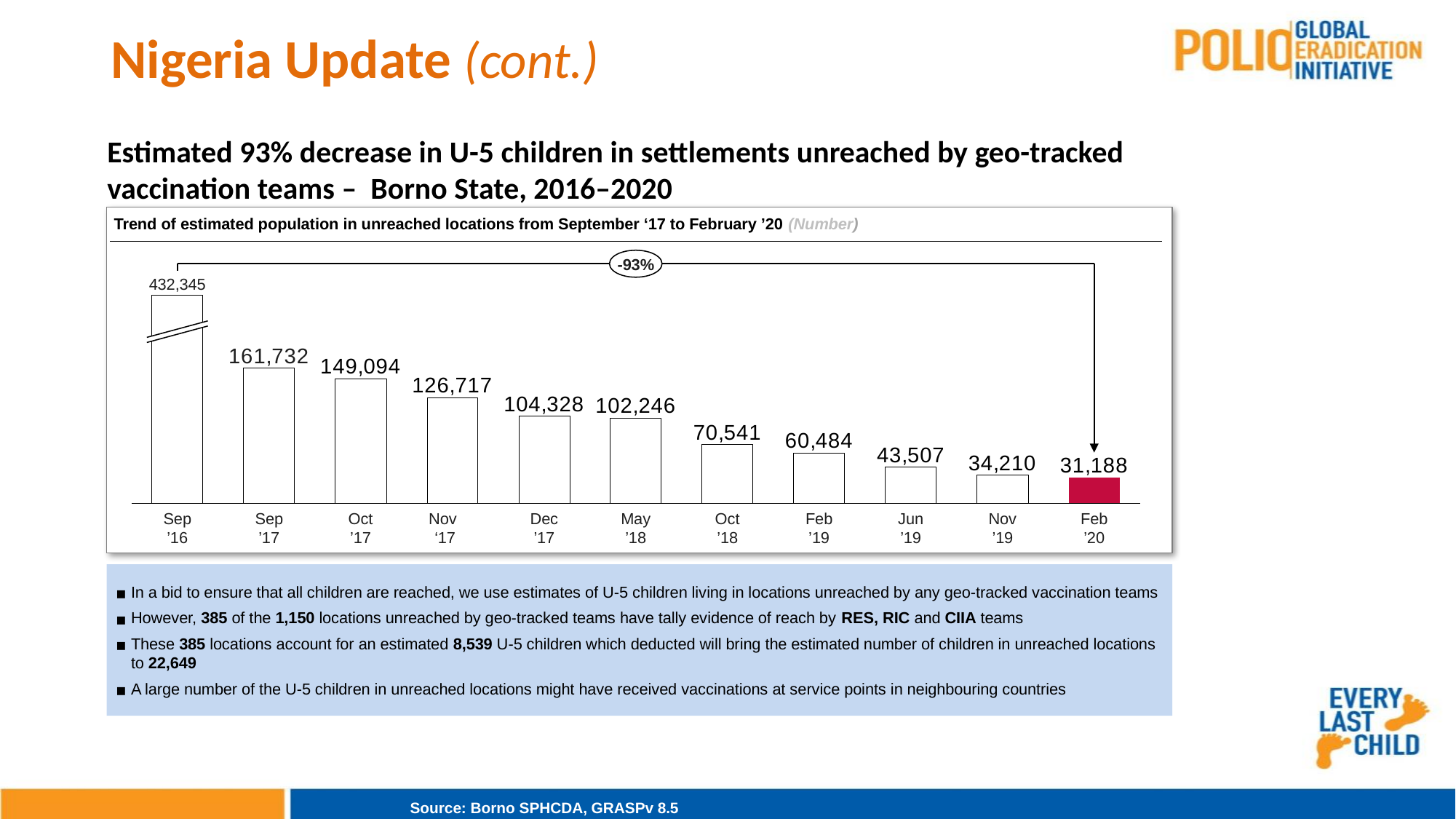
What is the difference between the values for Sep '17 and Oct '17? 12,638 Which period has the highest estimated population in unreached locations? Sep '16 What is the difference between the values for Nov '19 and Feb '20? 3,022 How many time periods (bars) are shown in the chart? 11 What type of chart is shown on the slide? Bar chart What is the estimated population in unreached locations for Feb '20? 31,188 Which is larger, the value for Dec '17 or the value for May '18? Dec '17 What is the estimated population in unreached locations for Sep '16? 432,345 What is the value shown for Oct '18? 70,541 Which period has the lowest estimated population in unreached locations? Feb '20 Do the values rise or fall from Sep '16 to Feb '20? Fall What percentage change is annotated above the chart between Sep '16 and Feb '20? -93%